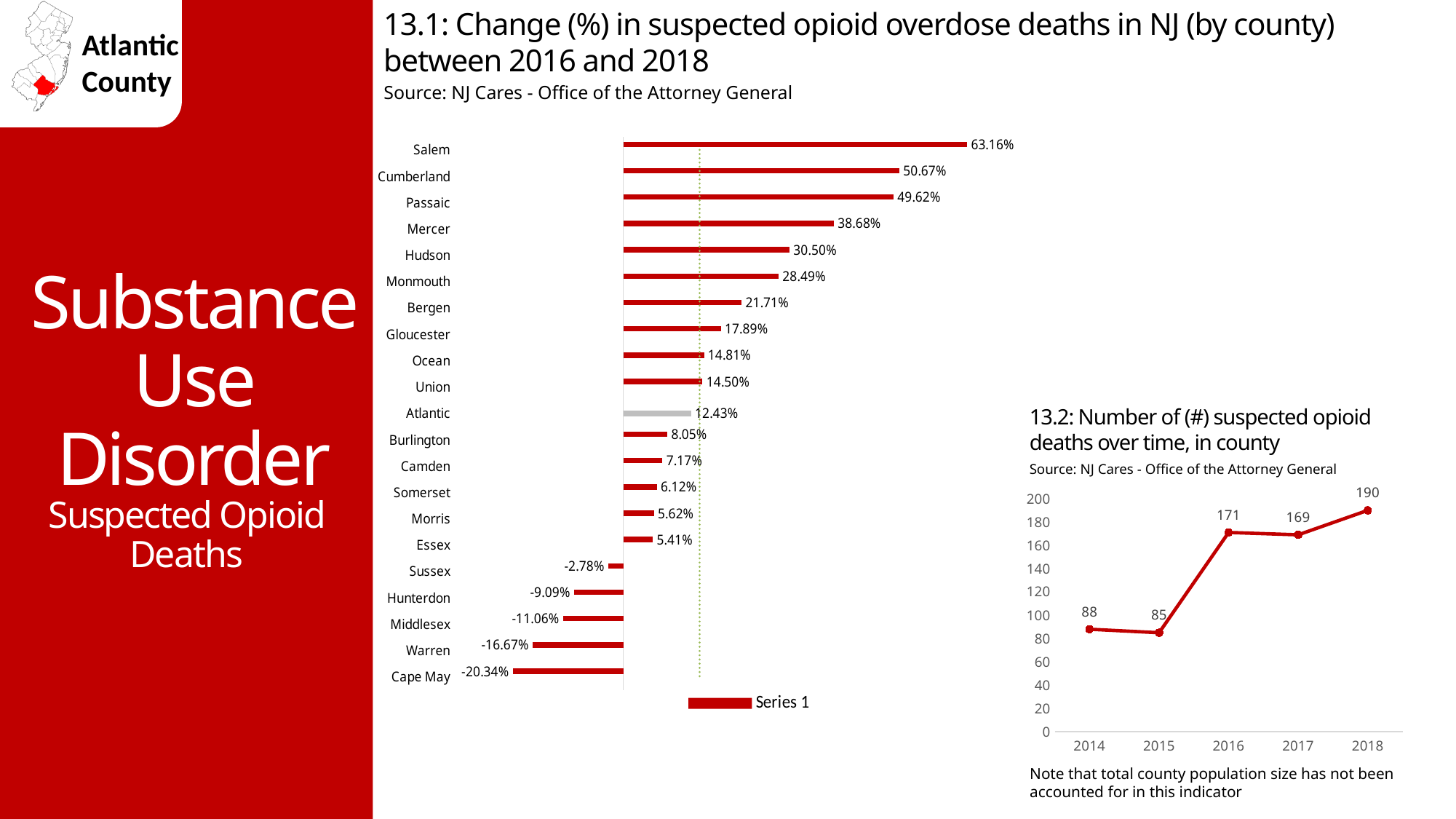
In chart 13.2, how many suspected opioid deaths were there in 2018? 190 In chart 13.1, what is the value shown for Passaic? 49.62% In chart 13.1, which is larger, the value for Hudson or the value for Monmouth? Hudson In chart 13.1, what is the difference between the values for Salem and Cumberland? 12.49% What kind of chart is chart 13.2? Line chart In chart 13.1, which county has the highest change (%) in suspected opioid overdose deaths? Salem In chart 13.1, what is the change (%) in suspected opioid overdose deaths for Atlantic county? 12.43% In chart 13.1, which county has the lowest change (%) in suspected opioid overdose deaths? Cape May In chart 13.2, which year has the lowest number of suspected opioid deaths? 2015 In chart 13.2, what is the difference in suspected opioid deaths between 2016 and 2015? 86 What kind of chart is chart 13.1? Bar chart In chart 13.1, how many counties are listed on the vertical axis? 21